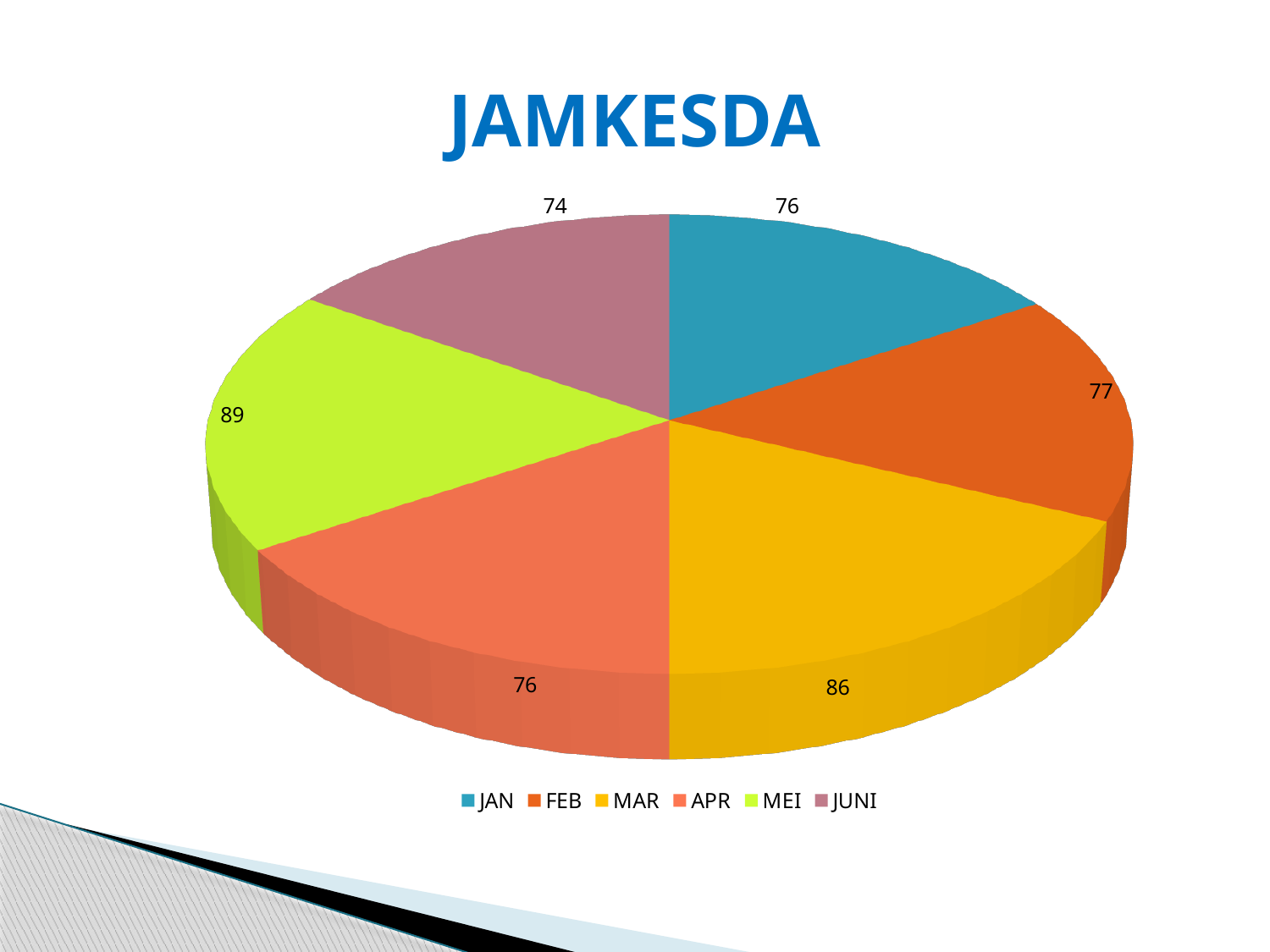
What is the title of the chart? JAMKESDA What is the difference between the values for MAR and JAN? 10 What is the value for MAR in the pie chart? 86 What is the difference between the values for MEI and JUNI? 15 What kind of chart is shown on the slide? Pie chart What is the value for MEI in the pie chart? 89 How many slices does the pie chart have? 6 What is the value for JUNI in the pie chart? 74 Which is larger, the value for FEB or the value for JAN? FEB How many entries does the legend list? 6 Which category has the smallest slice in the pie chart? JUNI Which category has the largest slice in the pie chart? MEI